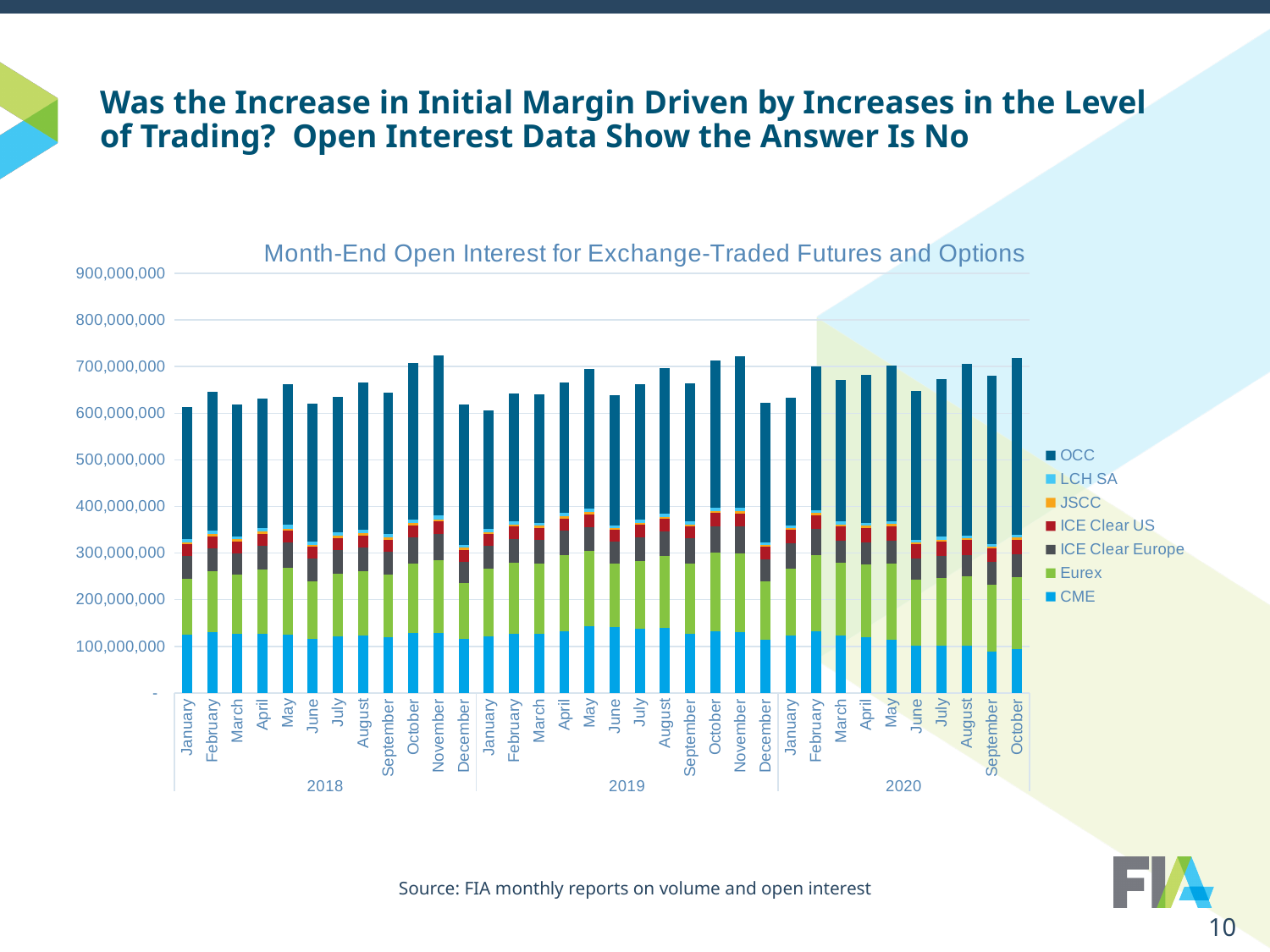
Is the CME segment for January 2018 greater or less than 100,000,000? greater How many series does the legend list? 7 What kind of chart is shown on the slide? Stacked bar chart How many monthly bars are plotted in the chart? 34 Which series forms the bottom segment of each stacked bar? CME Is the total open interest for June 2020 greater or less than 700,000,000? less What is the title of the chart? Month-End Open Interest for Exchange-Traded Futures and Options Is the total open interest for November 2018 greater or less than 700,000,000? greater Which month has the larger total open interest, November 2018 or June 2018? November 2018 Does the CME segment rise or fall from January 2020 to October 2020? fall